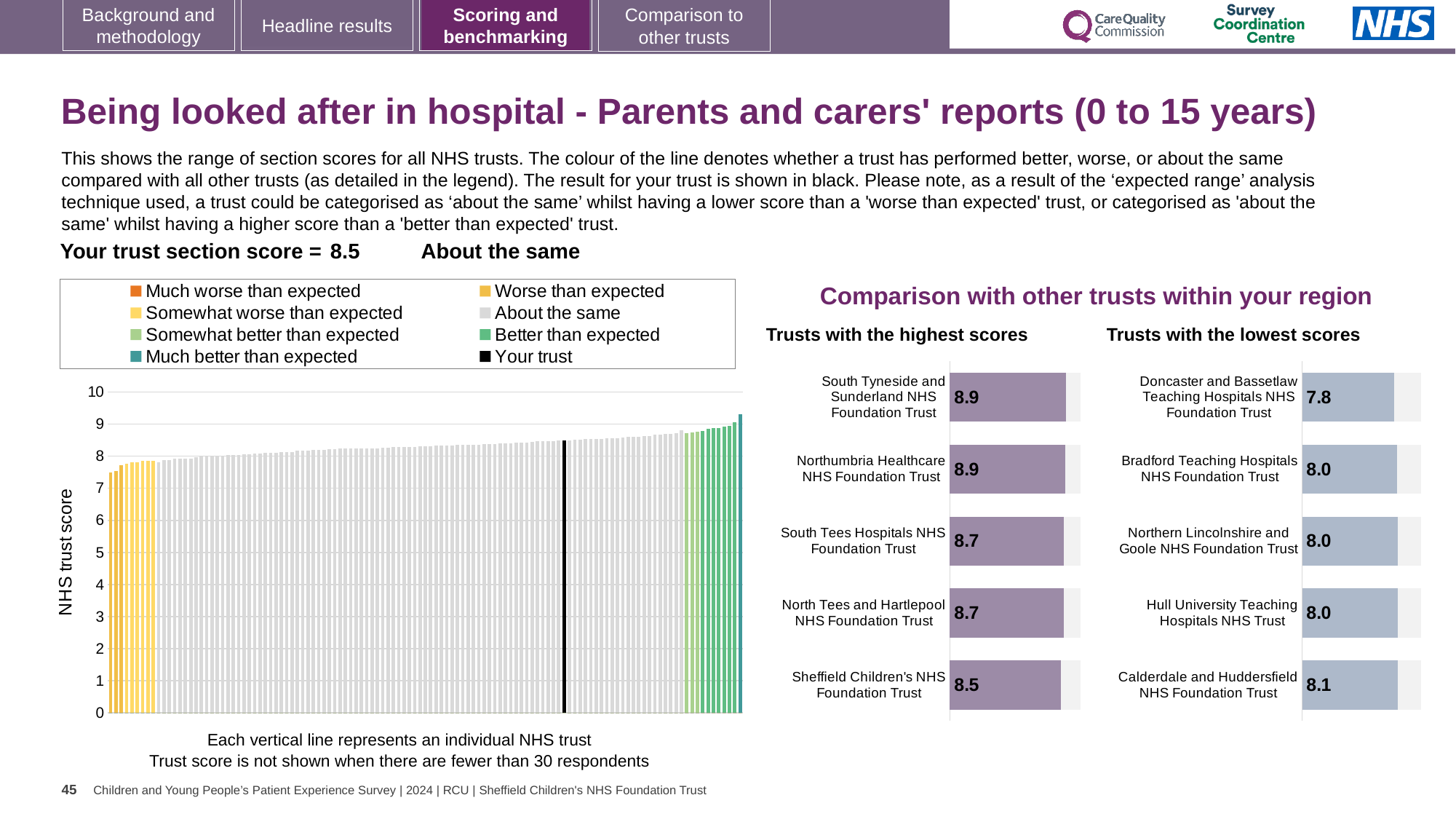
In the 'Trusts with the highest scores' chart, which has the higher score: Northumbria Healthcare NHS Foundation Trust or North Tees and Hartlepool NHS Foundation Trust? Northumbria Healthcare NHS Foundation Trust How many entries does the legend above the large chart on the left list? 8 In the 'Trusts with the lowest scores' chart, which trust has the lowest score? Doncaster and Bassetlaw Teaching Hospitals NHS Foundation Trust In the 'Trusts with the lowest scores' chart, what is the difference between the score for Calderdale and Huddersfield NHS Foundation Trust and the score for Doncaster and Bassetlaw Teaching Hospitals NHS Foundation Trust? 0.3 In the large chart on the left, is the value for the black bar (your trust) greater or less than 8? greater In the 'Trusts with the highest scores' chart, what is the score for Sheffield Children's NHS Foundation Trust? 8.5 In the large chart on the left, do the trust scores rise or fall from left to right along the x axis? rise How many trusts are shown in the 'Trusts with the lowest scores' chart? 5 In the 'Trusts with the highest scores' chart, what is the score for South Tees Hospitals NHS Foundation Trust? 8.7 In the 'Trusts with the lowest scores' chart, what is the score for Calderdale and Huddersfield NHS Foundation Trust? 8.1 In the 'Trusts with the highest scores' chart, what is the difference between the score for South Tyneside and Sunderland NHS Foundation Trust and the score for Sheffield Children's NHS Foundation Trust? 0.4 In the 'Trusts with the lowest scores' chart, what is the score for Doncaster and Bassetlaw Teaching Hospitals NHS Foundation Trust? 7.8